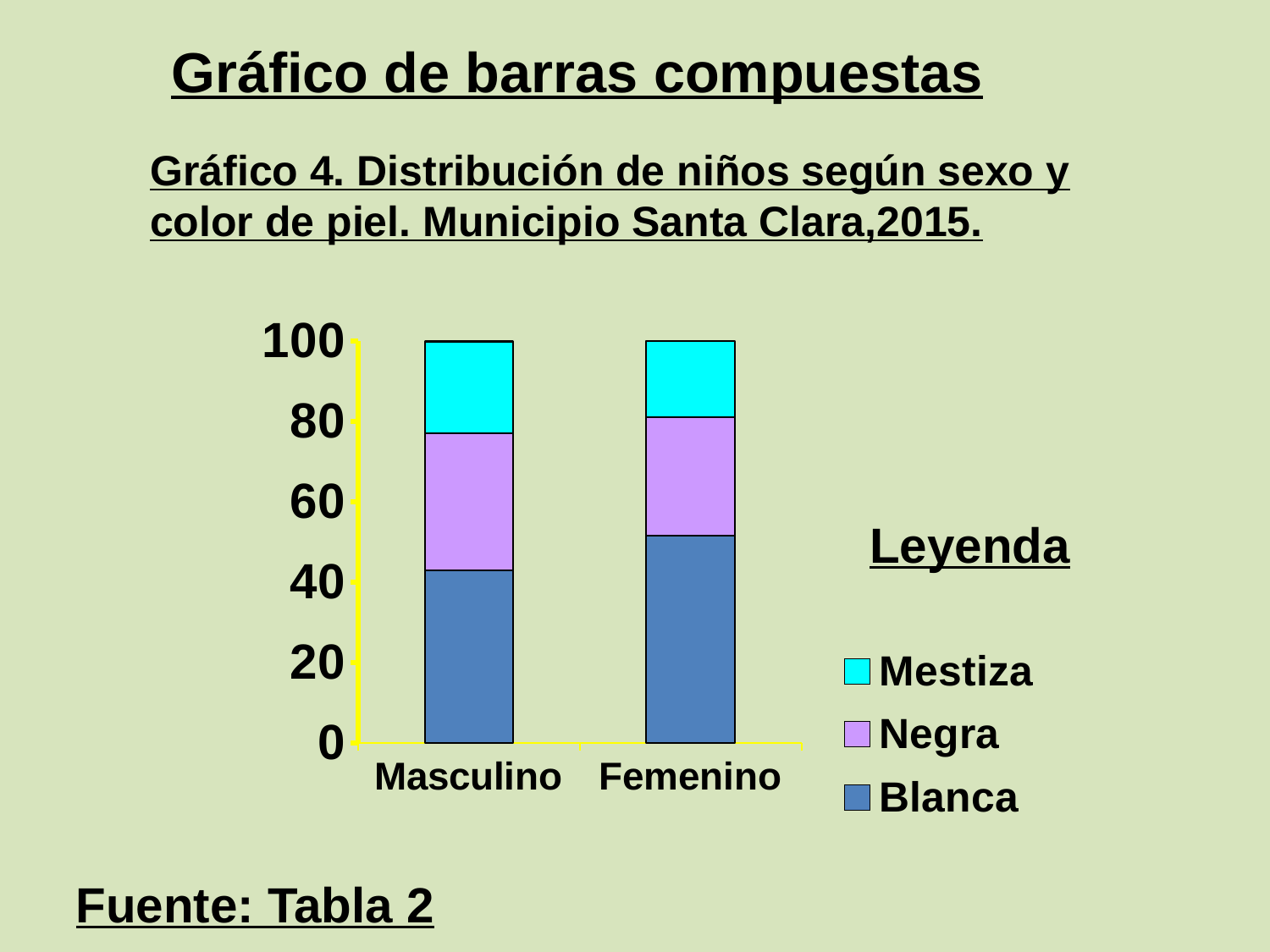
Is the Blanca value for Femenino greater or less than 40? greater Which series is shown in cyan in the legend? Mestiza Is the Blanca value for Masculino greater or less than 60? less What source is cited below the chart? Fuente: Tabla 2 What kind of chart is shown on the slide? Stacked bar chart How many series does the legend list? 3 Which category has the larger Mestiza segment, Masculino or Femenino? Masculino What is the total height of the Masculino stacked bar? 100 Which category has the larger Blanca segment, Masculino or Femenino? Femenino Is the Blanca value for Femenino greater or less than 60? less What is the total height of the Femenino stacked bar? 100 How many categories are shown on the x axis of the chart? 2